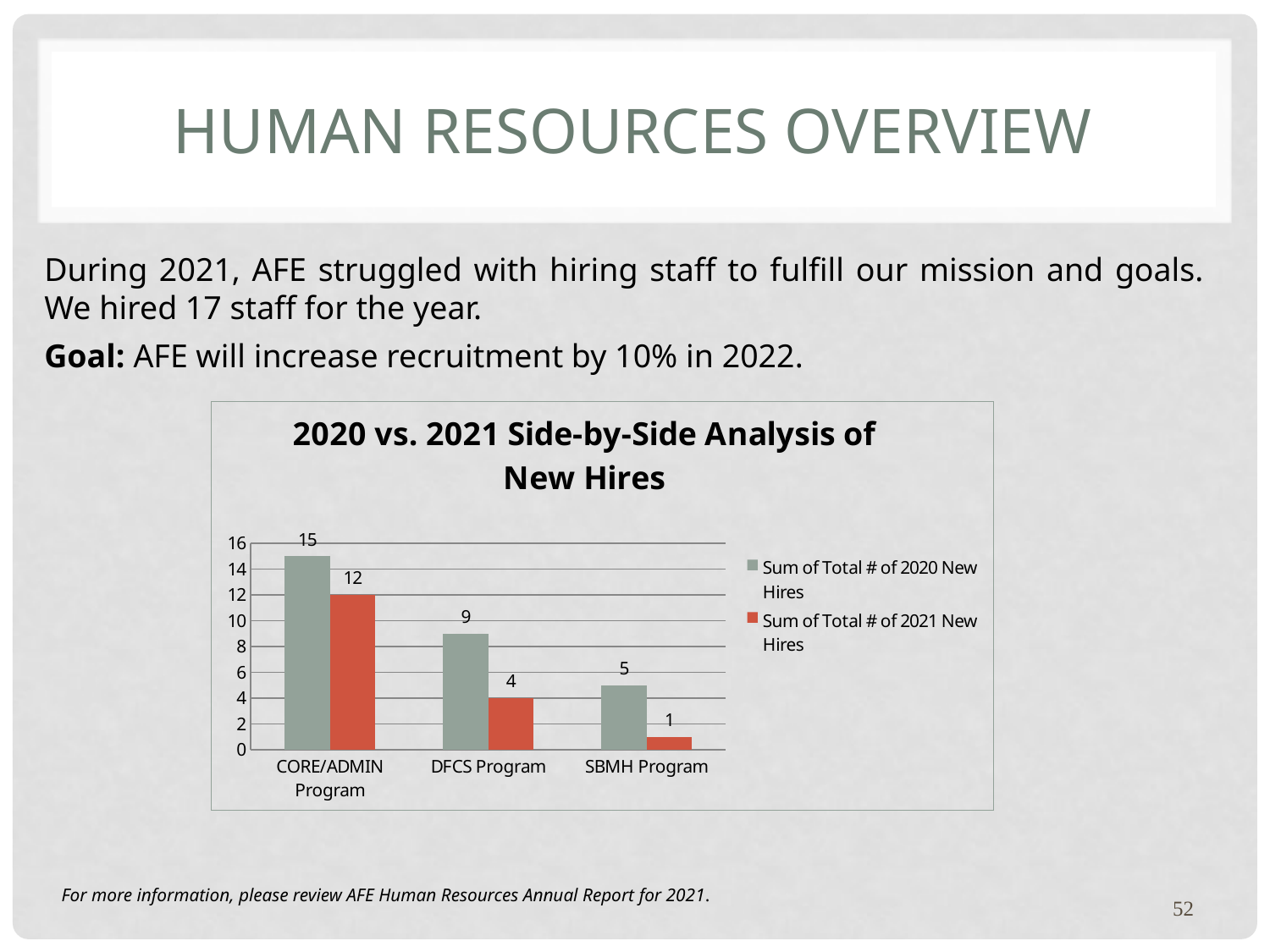
What is the title of the chart? 2020 vs. 2021 Side-by-Side Analysis of New Hires Which program has the lowest Sum of Total # of 2021 New Hires? SBMH Program How many programs are shown on the x axis of the chart? 3 What is the Sum of Total # of 2021 New Hires for the DFCS Program? 4 Which is larger for the SBMH Program: the 2020 new hires or the 2021 new hires? 2020 new hires How many series does the chart legend list? 2 What is the Sum of Total # of 2020 New Hires for the CORE/ADMIN Program? 15 What kind of chart is shown on the slide? Bar chart Do the 2021 new hires values rise or fall from CORE/ADMIN Program to SBMH Program? Fall What is the Sum of Total # of 2021 New Hires for the SBMH Program? 1 Which program has the highest Sum of Total # of 2020 New Hires? CORE/ADMIN Program What is the difference between the 2020 and 2021 new hires for the DFCS Program? 5